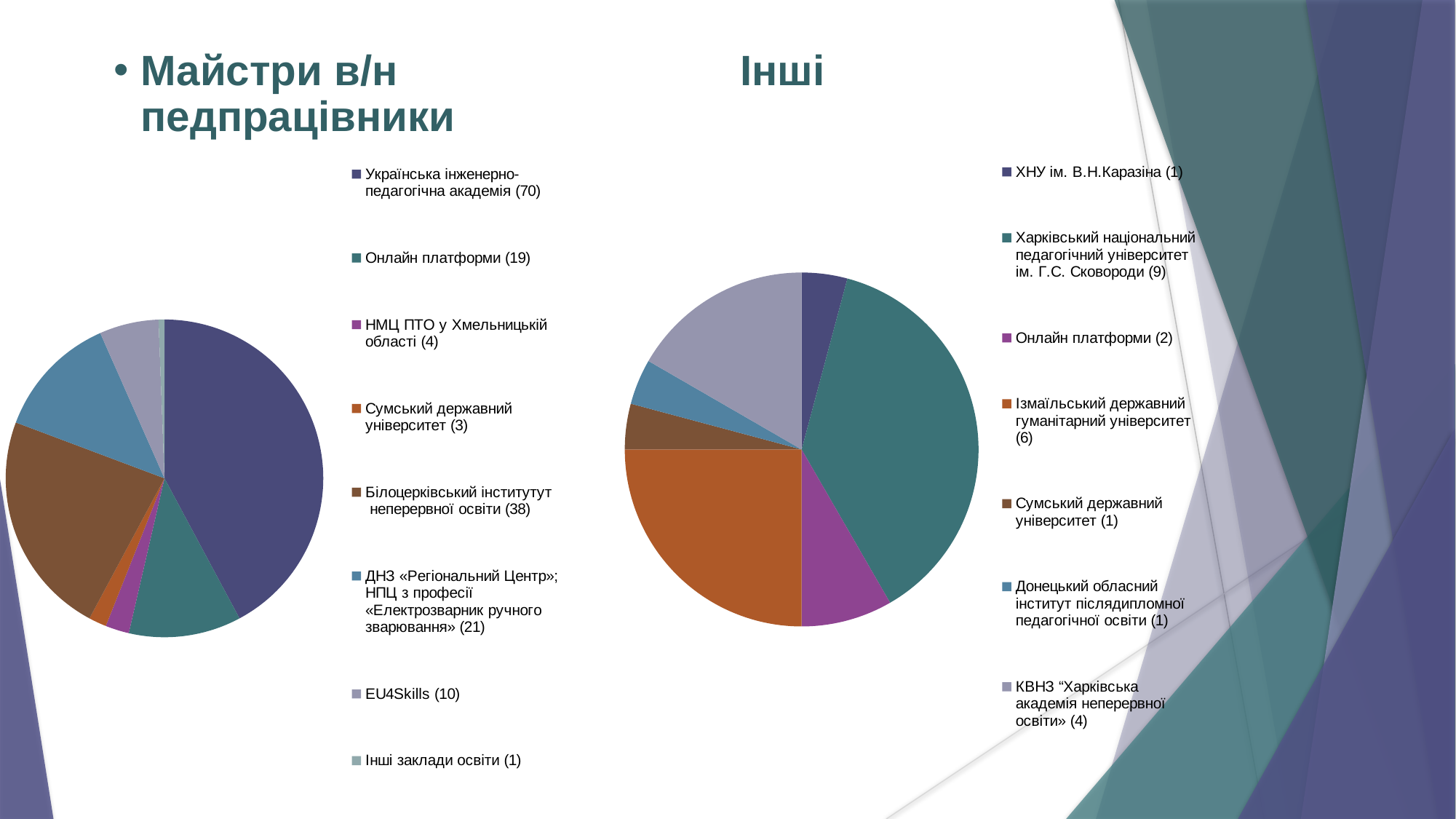
In the left pie chart (Майстри в/н педпрацівники), what is the value for Українська інженерно-педагогічна академія? 70 In the left pie chart (Майстри в/н педпрацівники), what is the difference between Онлайн платформи and EU4Skills? 9 In the left pie chart (Майстри в/н педпрацівники), what is the value for Білоцерківський інститутут неперервної освіти? 38 How many categories does the right pie chart (Інші) show? 7 In the left pie chart (Майстри в/н педпрацівники), which category has the smallest value? Інші заклади освіти In the left pie chart (Майстри в/н педпрацівники), which category has the largest value? Українська інженерно-педагогічна академія In the right pie chart (Інші), which is larger: Онлайн платформи or КВНЗ «Харківська академія неперервної освіти»? КВНЗ «Харківська академія неперервної освіти» In the right pie chart (Інші), what is the value for Ізмаїльський державний гуманітарний університет? 6 In the right pie chart (Інші), which category has the largest value? Харківський національний педагогічний університет ім. Г.С. Сковороди What type of chart is used for Інші on the right of the slide? Pie chart How many categories does the left pie chart (Майстри в/н педпрацівники) show? 8 In the right pie chart (Інші), what share of the total does Харківський національний педагогічний університет ім. Г.С. Сковороди represent? 37.5%